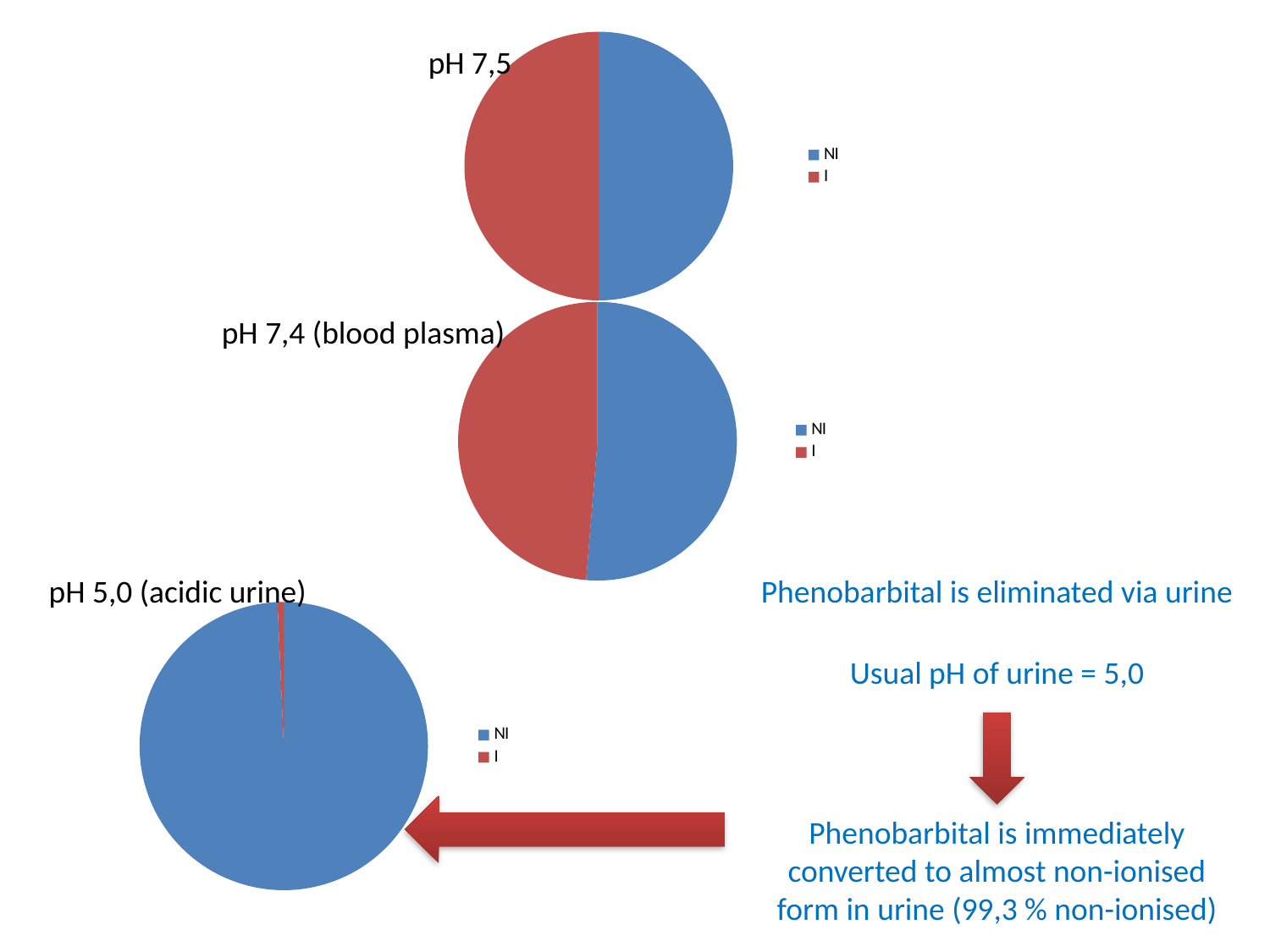
In the "pH 5,0 (acidic urine)" chart, which category has the smallest slice? I What kind of chart is the "pH 5,0 (acidic urine)" chart? pie chart In the "pH 7,4 (blood plasma)" chart, what colour is the I slice? red How many slices does the "pH 7,5" chart have? 2 In the "pH 5,0 (acidic urine)" chart, which slice is larger, NI or I? NI How many pie charts are shown on the slide? 3 In the "pH 5,0 (acidic urine)" chart, which category has the largest slice? NI What are the legend entries of the "pH 5,0 (acidic urine)" chart? NI and I How many series does the legend of the "pH 7,4 (blood plasma)" chart list? 2 What kind of chart is the "pH 7,5" chart? pie chart